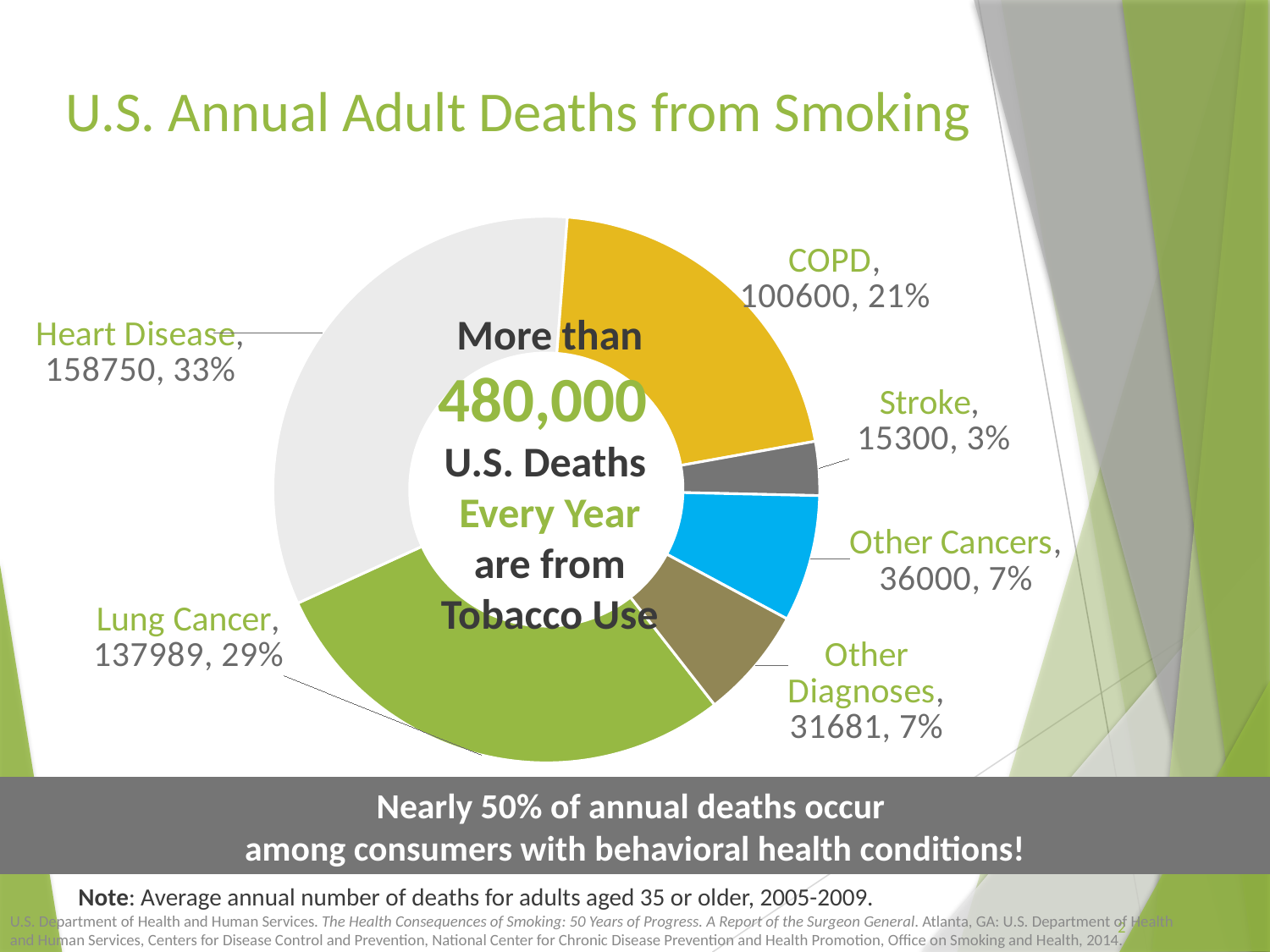
How many categories are shown in the chart? 6 What percentage share of deaths does Lung Cancer represent? 29% Which category accounts for the smallest share of deaths in the chart? Stroke What percentage share of deaths does COPD represent? 21% Which category accounts for the largest share of deaths in the chart? Heart Disease Which has more deaths, Other Cancers or Other Diagnoses? Other Cancers What kind of chart is shown on the slide? doughnut chart What is the number of deaths shown for COPD? 100600 What is the difference in deaths between Heart Disease and Lung Cancer? 20761 How many deaths are attributed to Heart Disease in the chart? 158750 What is the number of deaths shown for Lung Cancer? 137989 What is the number of deaths shown for Stroke? 15300